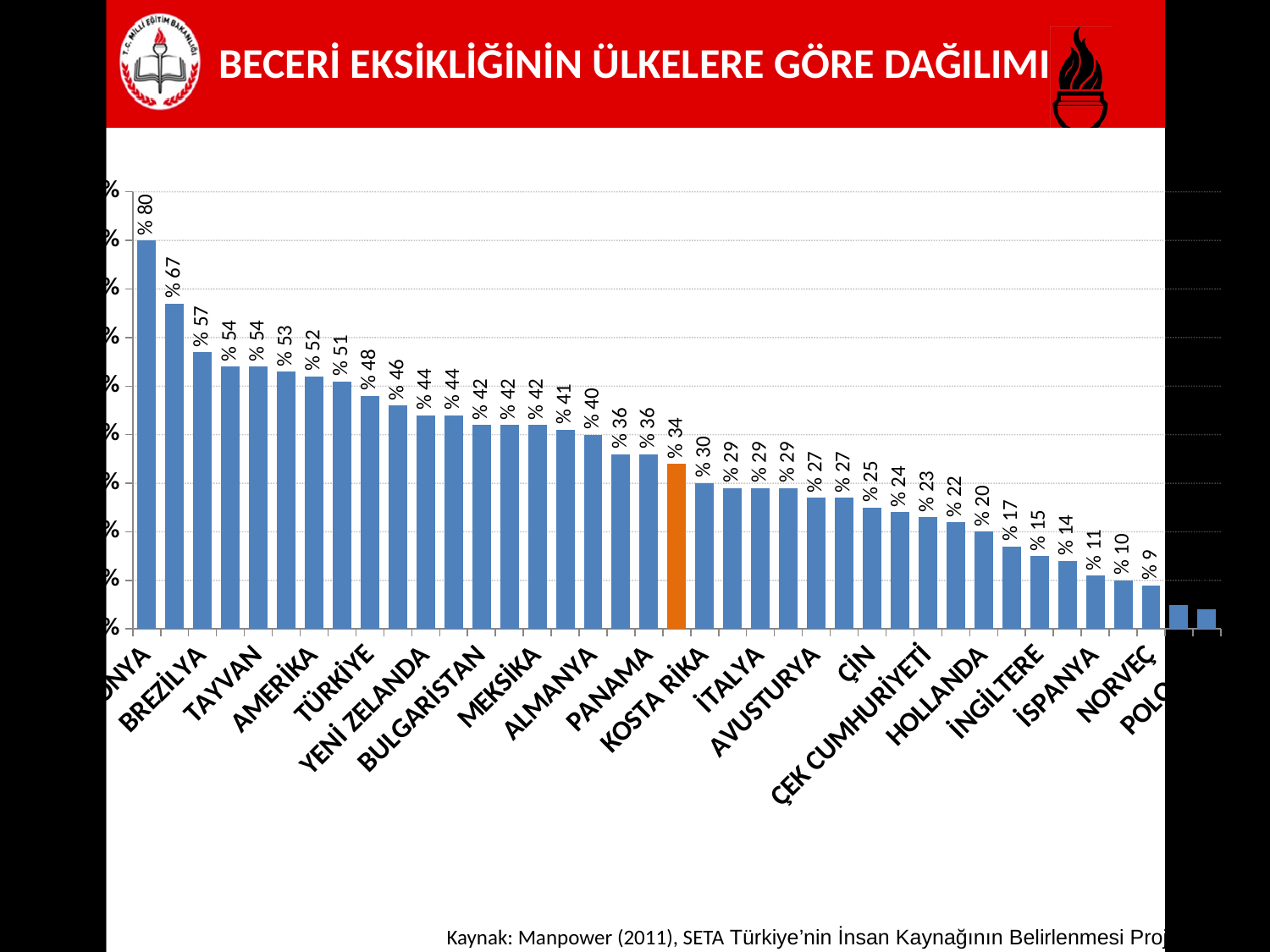
What is the value for ALMANYA? % 40 What is the difference between the values for TÜRKİYE and ALMANYA? 8 What kind of chart is shown on the slide? bar chart What is the value for HOLLANDA? % 20 Do the values rise or fall from left to right along the x axis? fall What is the highest value shown in the chart? % 80 What is the value of the orange-highlighted bar? % 34 What is the value for NORVEÇ? % 9 Which has the larger value, PANAMA or İTALYA? PANAMA What is the value for BREZİLYA? % 57 What is the value for TÜRKİYE? % 48 What is the value for İNGİLTERE? % 15